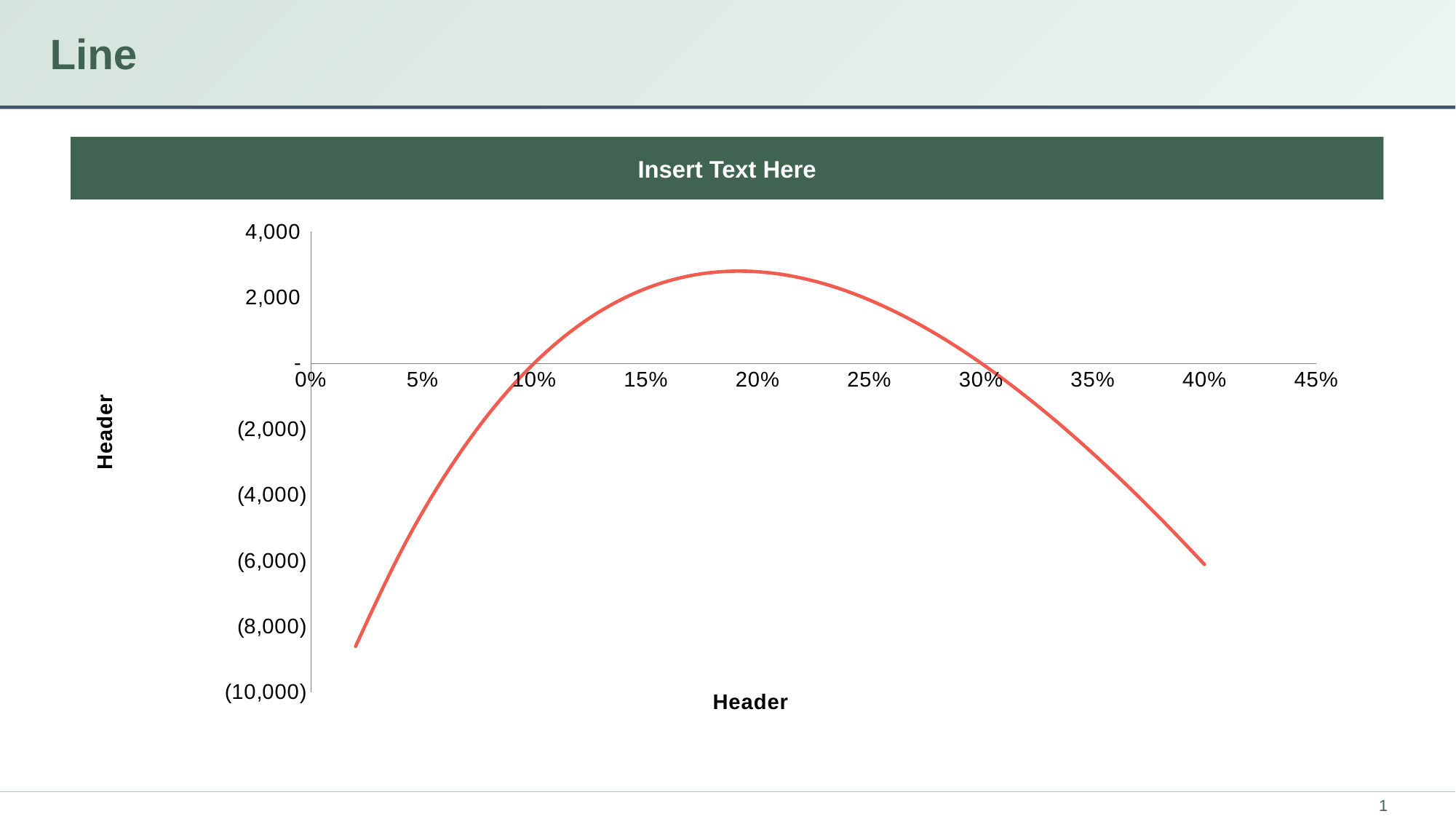
Is the value of the line at 25% greater or less than 0? greater What is the label on the vertical axis of the chart? Header Is the value of the line at 15% greater or less than 0? greater Is the value of the line at 40% greater or less than (4,000)? less Does the line rise or fall between 0% and 20% on the x axis? rises Does the line rise or fall between 20% and 40% on the x axis? falls What kind of chart is shown on the slide? line chart Is the value of the line at 5% greater or less than the value at 20%? less